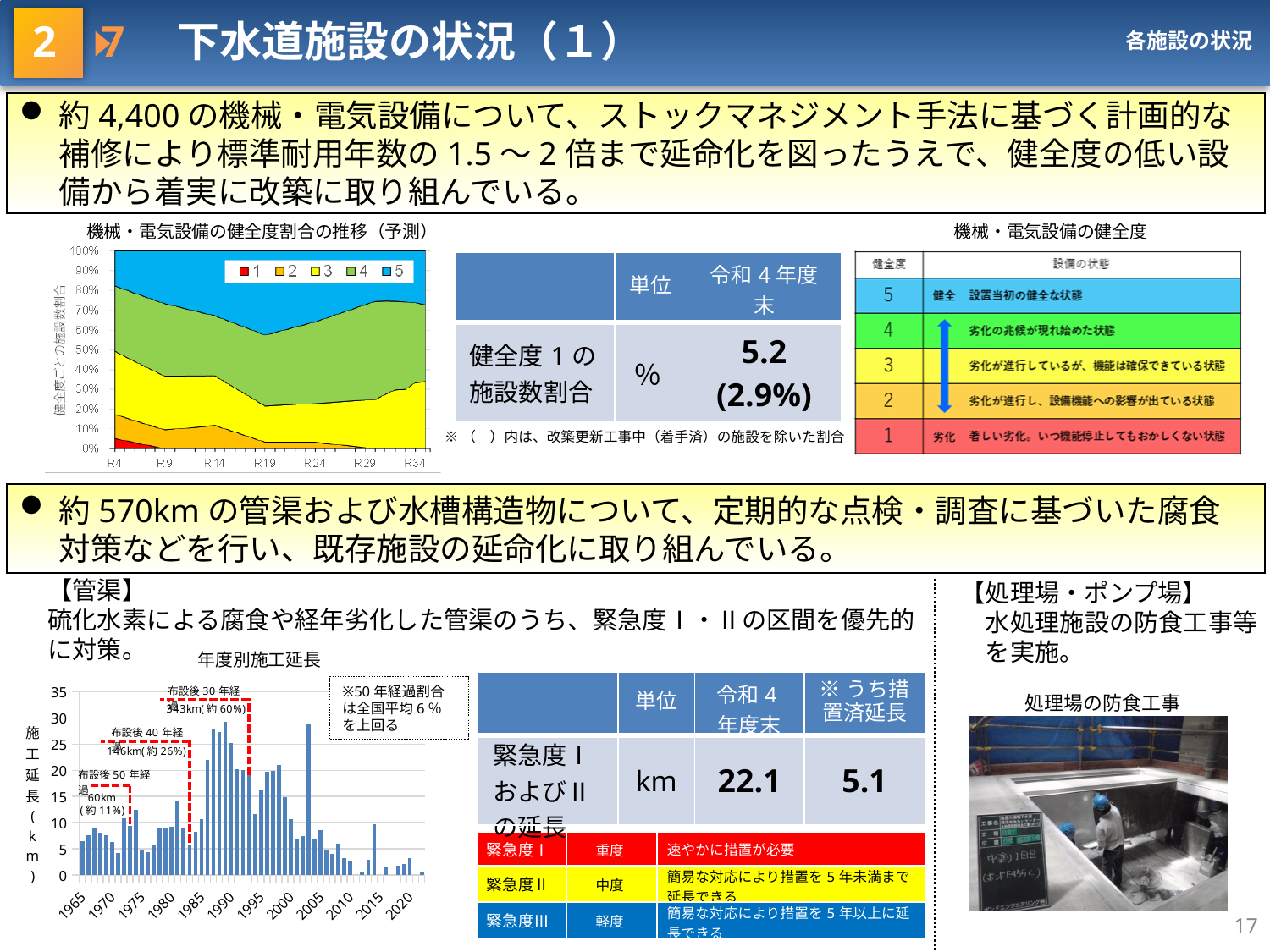
On the 年度別施工延長 chart, is the value for 2010 greater or less than 10? less On the 年度別施工延長 chart, is the value for 1965 greater or less than 10? less How many series does the legend of the 機械・電気設備の健全度割合の推移（予測） chart list? 5 On the 年度別施工延長 chart, is the value for 2020 greater or less than 5? less What is the last x-axis label on the 機械・電気設備の健全度割合の推移（予測） chart? R34 On the 年度別施工延長 chart, do the values generally rise or fall from 1995 to 2010? fall What is the first x-axis label on the 機械・電気設備の健全度割合の推移（予測） chart? R4 On the 年度別施工延長 chart, which is larger, the value for 1990 or the value for 2010? 1990 What is the maximum value shown on the y axis of the 年度別施工延長 chart? 35 What kind of chart is the 機械・電気設備の健全度割合の推移（予測） chart at the top left? stacked area chart What kind of chart is the 年度別施工延長 chart at the bottom left? bar chart